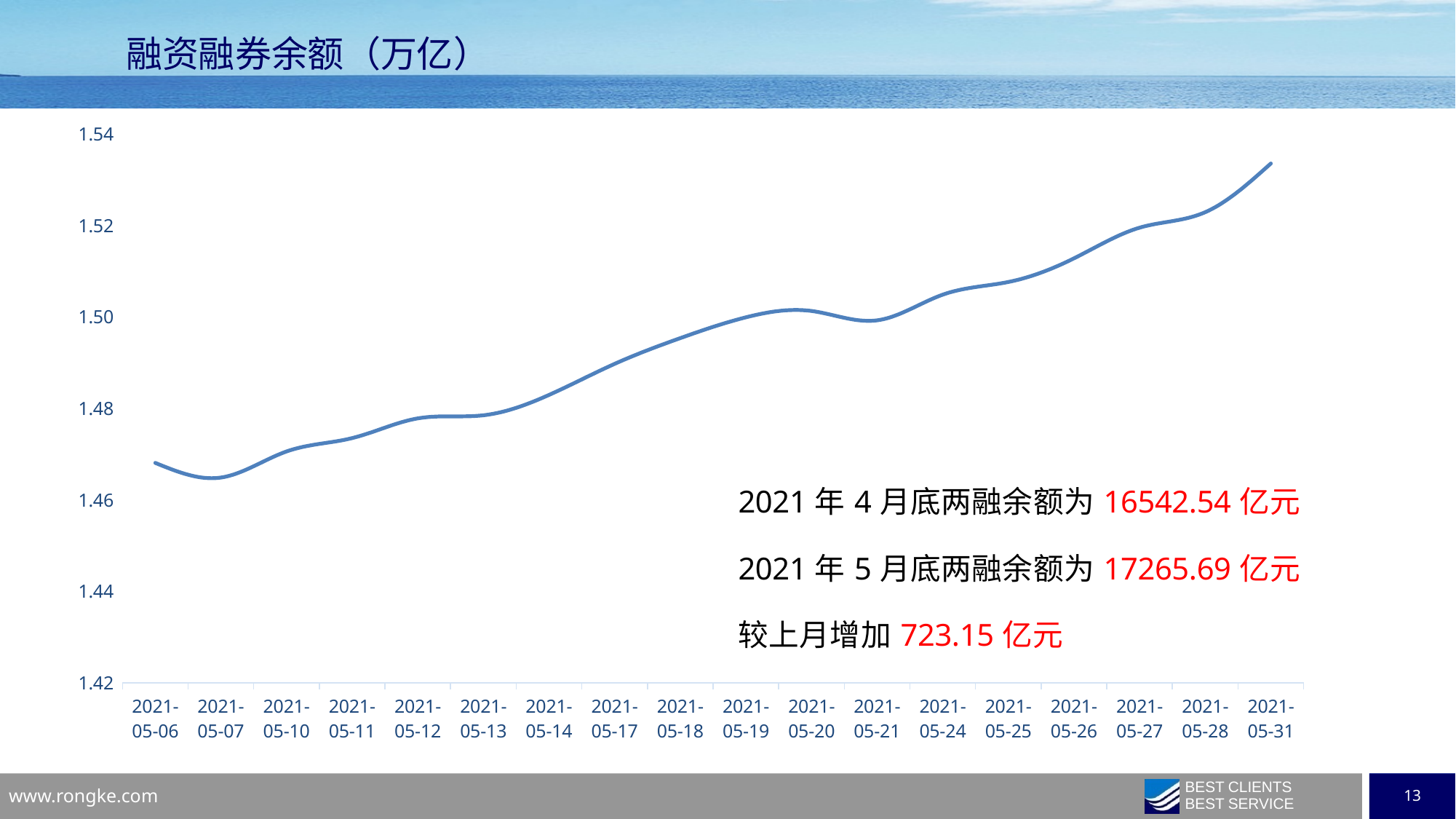
Is the value for 2021-05-24 greater or less than 1.50? greater Is the value for 2021-05-31 greater or less than 1.52? greater Which date has the larger value, 2021-05-13 or 2021-05-26? 2021-05-26 What is the title of the chart? 融资融券余额（万亿） Does the line generally rise or fall from 2021-05-06 to 2021-05-31? rise Which date has the larger value, 2021-05-06 or 2021-05-07? 2021-05-06 What kind of chart is shown on the slide? line chart How many dates are plotted along the x axis of the chart? 18 On which date does the line reach its lowest value? 2021-05-07 Is the value for 2021-05-06 greater or less than 1.48? less On which date does the line reach its highest value? 2021-05-31